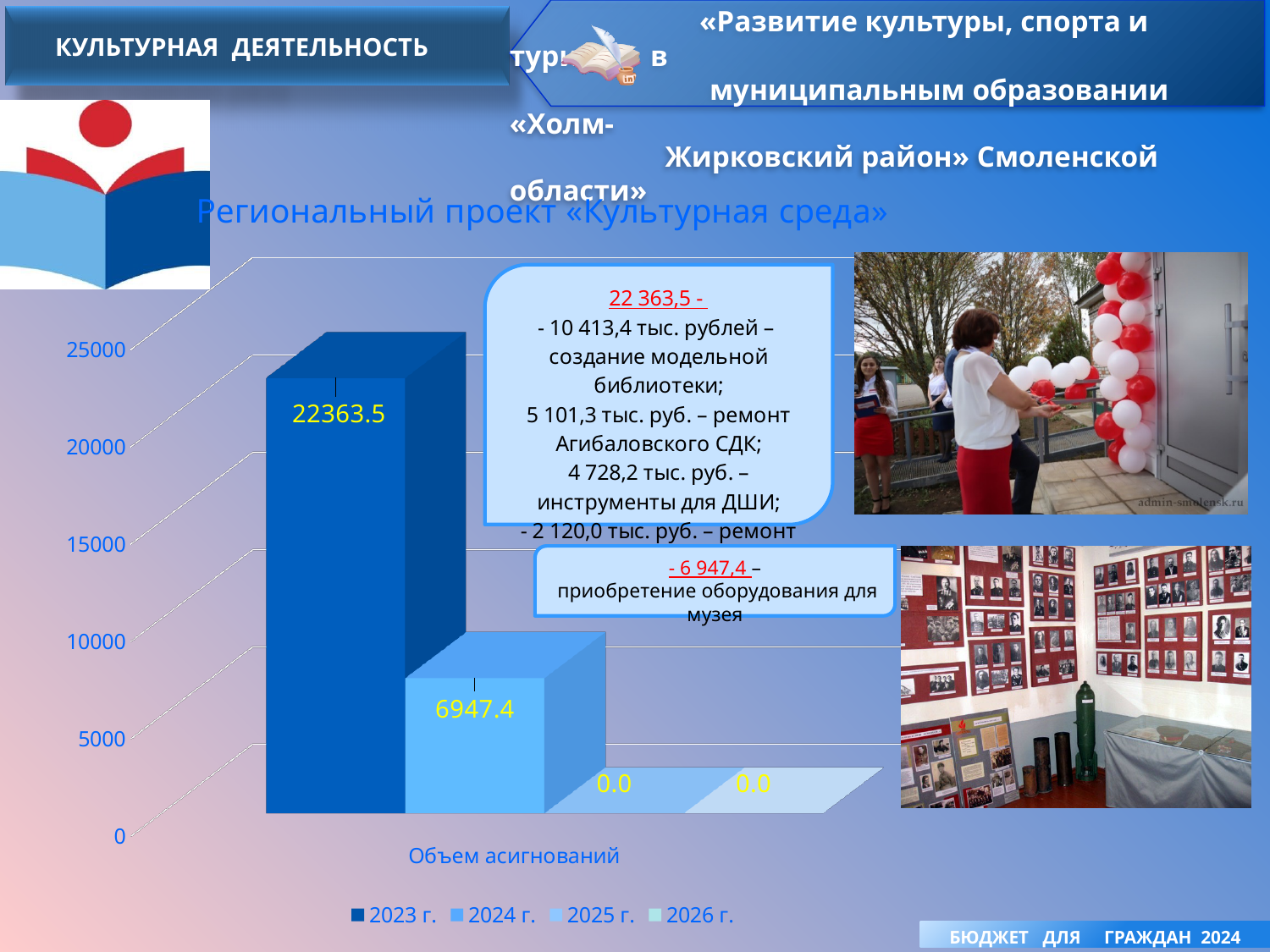
What is the category label shown on the x axis of the chart? Объем асигнований Is the value for 2024 г. greater or less than 10000? less Is the value for 2023 г. greater or less than 20000? greater What is the value for 2025 г. in the chart? 0.0 Which is larger, the value for 2023 г. or the value for 2024 г.? 2023 г. How many series does the legend list? 4 What is the value for 2023 г. in the chart? 22363.5 Which year has the highest value in the chart? 2023 г. What is the value for 2026 г. in the chart? 0.0 What is the difference between the values for 2023 г. and 2024 г.? 15416.1 What kind of chart is shown on the slide? bar chart What is the value for 2024 г. in the chart? 6947.4